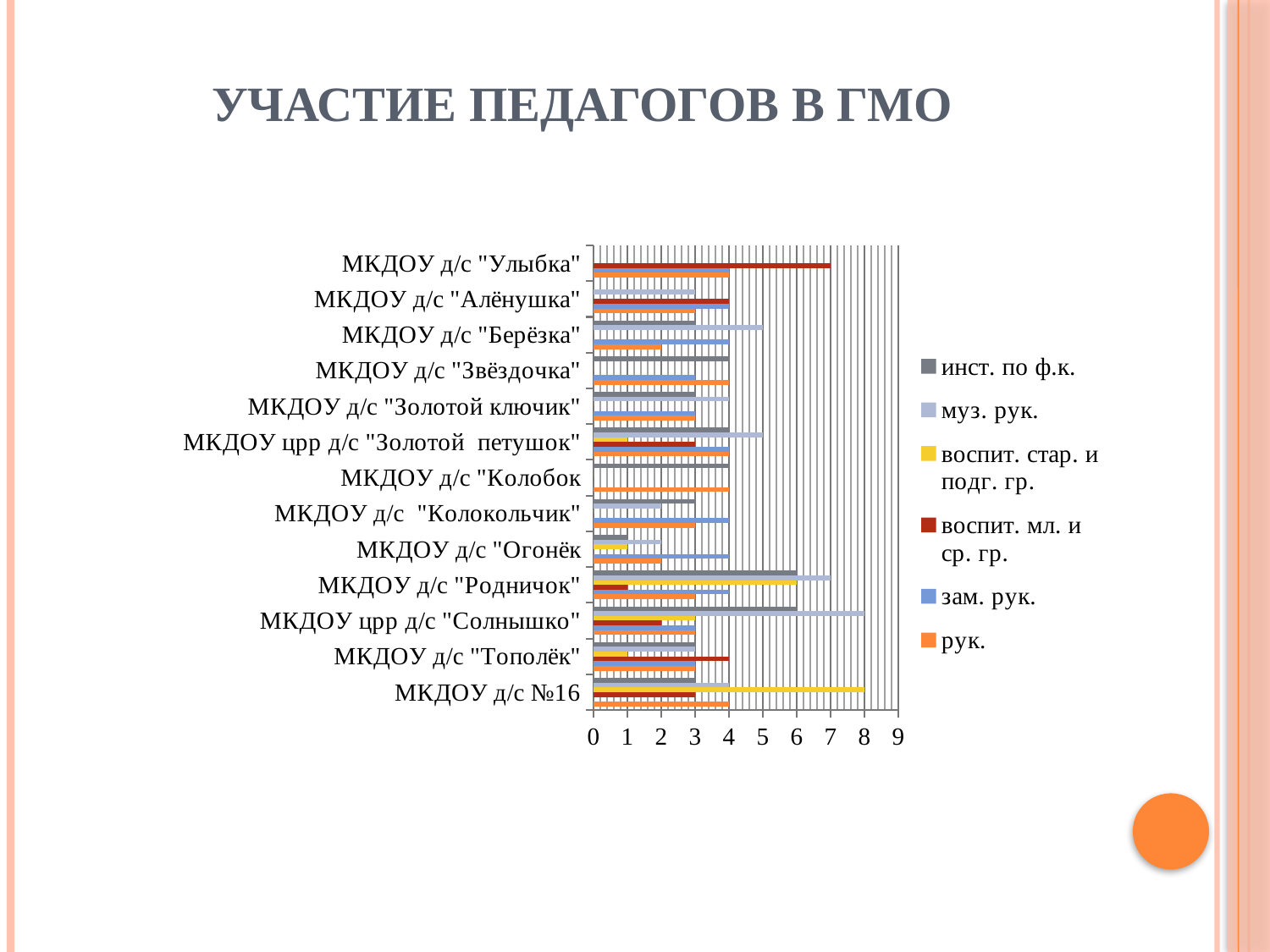
Which is larger: the "муз. рук." value for МКДОУ д/с "Родничок" or for МКДОУ д/с "Берёзка"? МКДОУ д/с "Родничок" What is the title of the chart on the slide? УЧАСТИЕ ПЕДАГОГОВ В ГМО How many series does the legend list? 6 Which legend entry is shown in yellow? воспит. стар. и подг. гр. Is the value of "воспит. мл. и ср. гр." for МКДОУ д/с "Улыбка" greater or less than 5? greater How many kindergartens (categories) are shown on the chart? 13 Is the value of "рук." for МКДОУ д/с "Берёзка" greater or less than 3? less What is the value of "муз. рук." for МКДОУ црр д/с "Солнышко"? 8 What is the value of "воспит. стар. и подг. гр." for МКДОУ д/с №16? 8 What kind of chart is shown on the slide? bar chart Which kindergarten has the highest value for "муз. рук."? МКДОУ црр д/с "Солнышко" What is the value of "воспит. мл. и ср. гр." for МКДОУ д/с "Улыбка"? 7